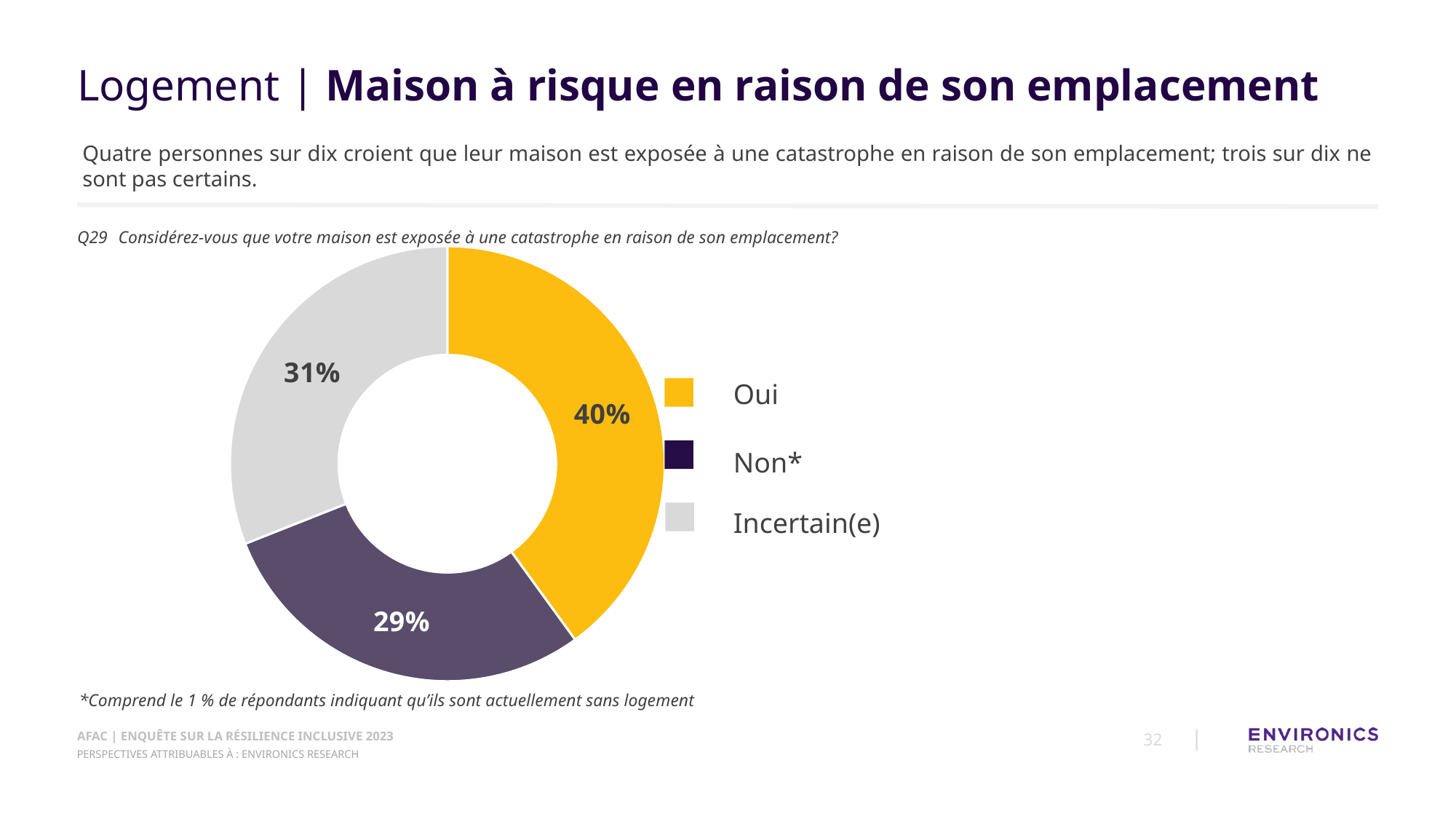
What percentage of respondents answered "Non*"? 29% What kind of chart is shown on the slide? Pie chart (donut) Which is larger, the share for "Oui" or the share for "Incertain(e)"? Oui Which response has the largest share of the chart? Oui What colour is the "Oui" slice? Yellow Which response has the smallest share of the chart? Non* What percentage of respondents answered "Incertain(e)"? 31% What is the difference in percentage points between "Incertain(e)" and "Non*"? 2 What percentage of respondents answered "Oui"? 40% What is the question number shown above the chart? Q29 What is the difference in percentage points between "Oui" and "Non*"? 11 How many categories are shown in the chart? 3